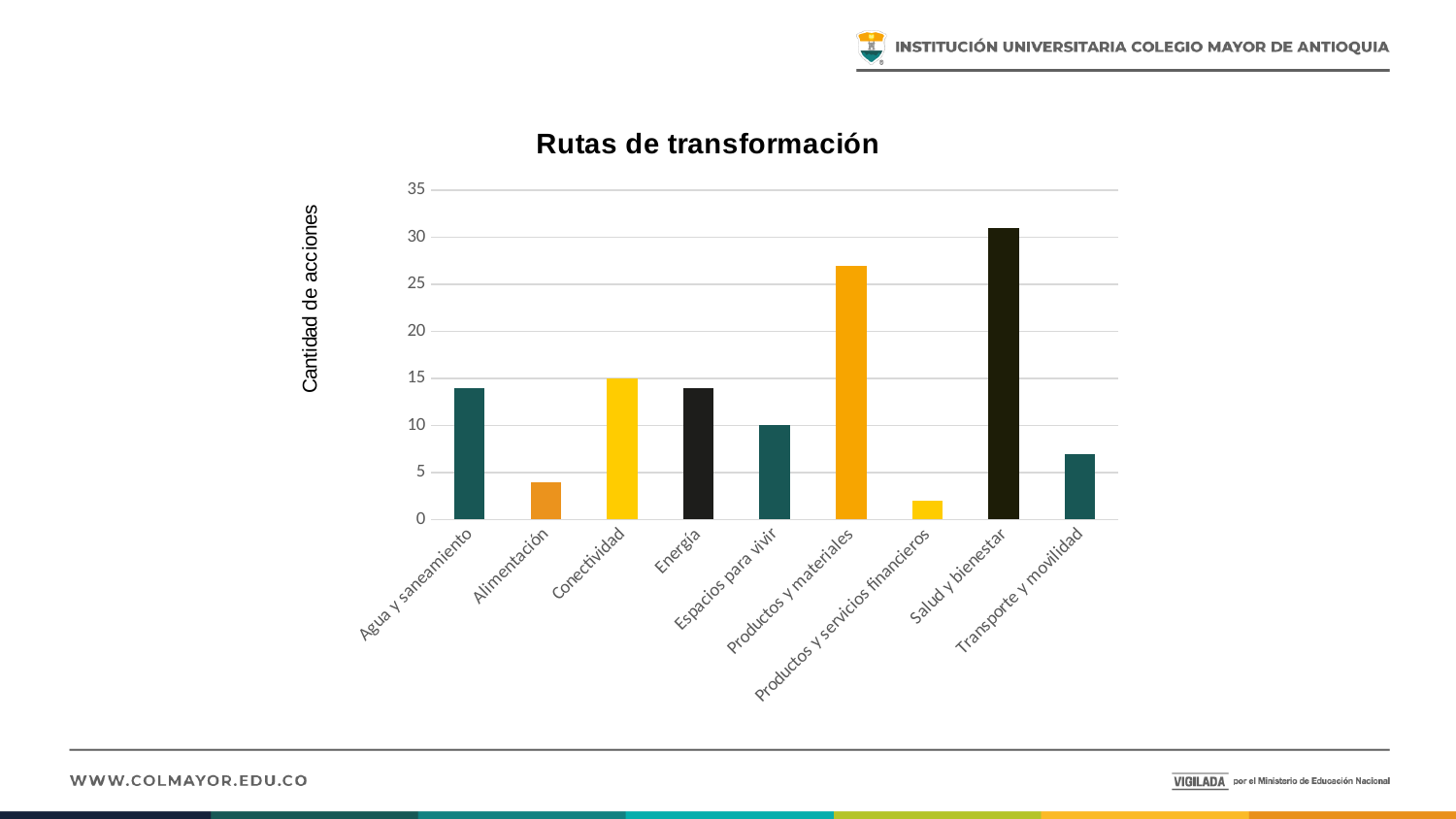
Is the value for Productos y materiales greater or less than 25? greater What is the label of the vertical axis? Cantidad de acciones Is the value for Alimentación greater or less than 5? less Which is larger, the value for Transporte y movilidad or the value for Alimentación? Transporte y movilidad What is the value for Espacios para vivir? 10 How many categories are shown on the x axis? 9 What is the value for Conectividad? 15 What is the title of the chart? Rutas de transformación What type of chart is shown on the slide? bar chart Which category has the highest value? Salud y bienestar Which category has the lowest value? Productos y servicios financieros Is the value for Salud y bienestar greater or less than 30? greater